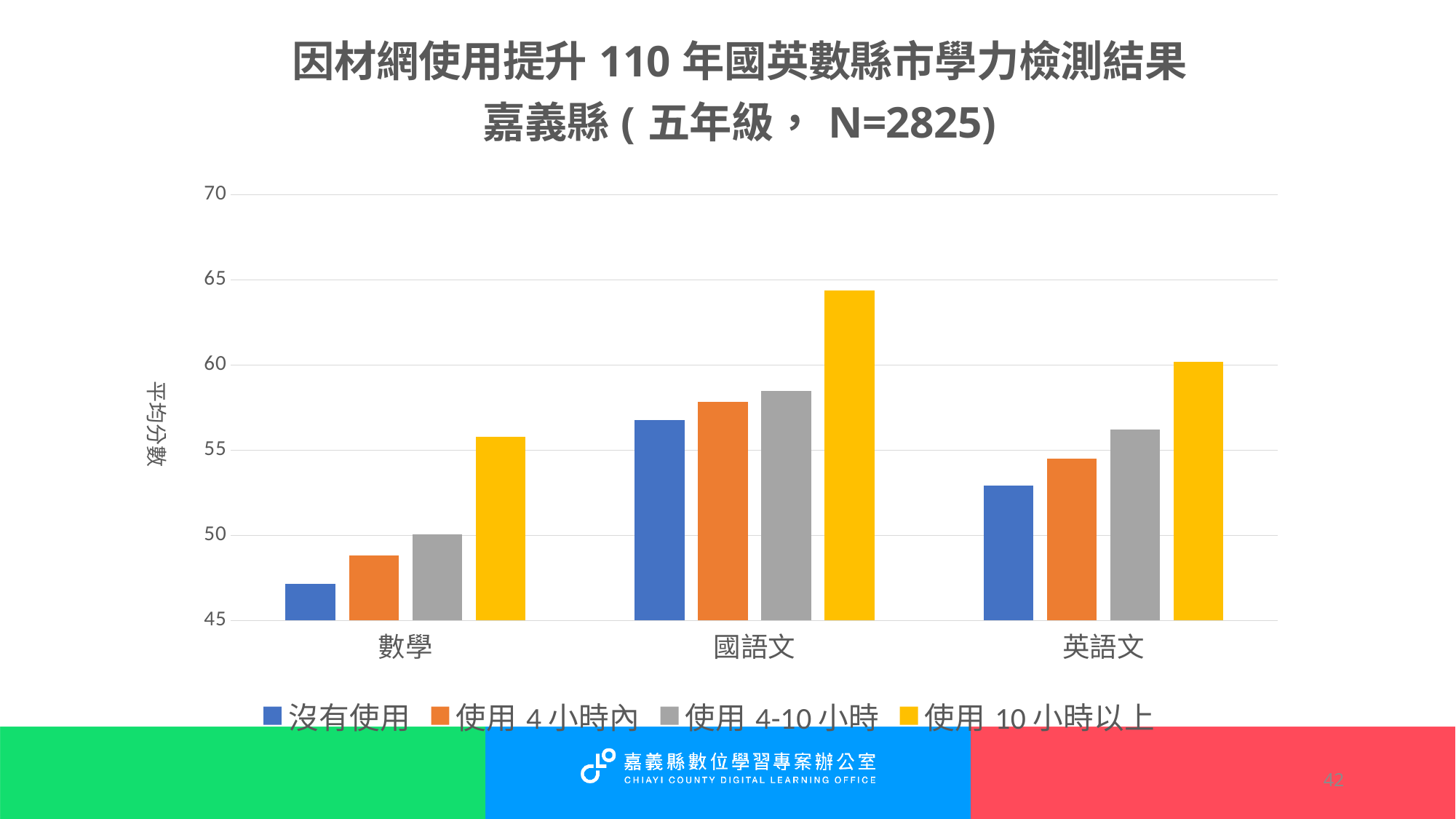
Which subject has the highest bar for 使用 10 小時以上? 國語文 Is the value for 使用 10 小時以上 in 國語文 greater or less than 60? greater Is the value for 沒有使用 in 國語文 greater or less than 55? greater What is the label on the vertical axis? 平均分數 How many series does the legend list? 4 What kind of chart is shown on the slide? bar chart Is the value for 沒有使用 in 數學 greater or less than 50? less How many subject categories are shown on the x axis? 3 Which is larger: the 沒有使用 value for 國語文 or for 英語文? 國語文 Which subject has the lowest bar for 沒有使用? 數學